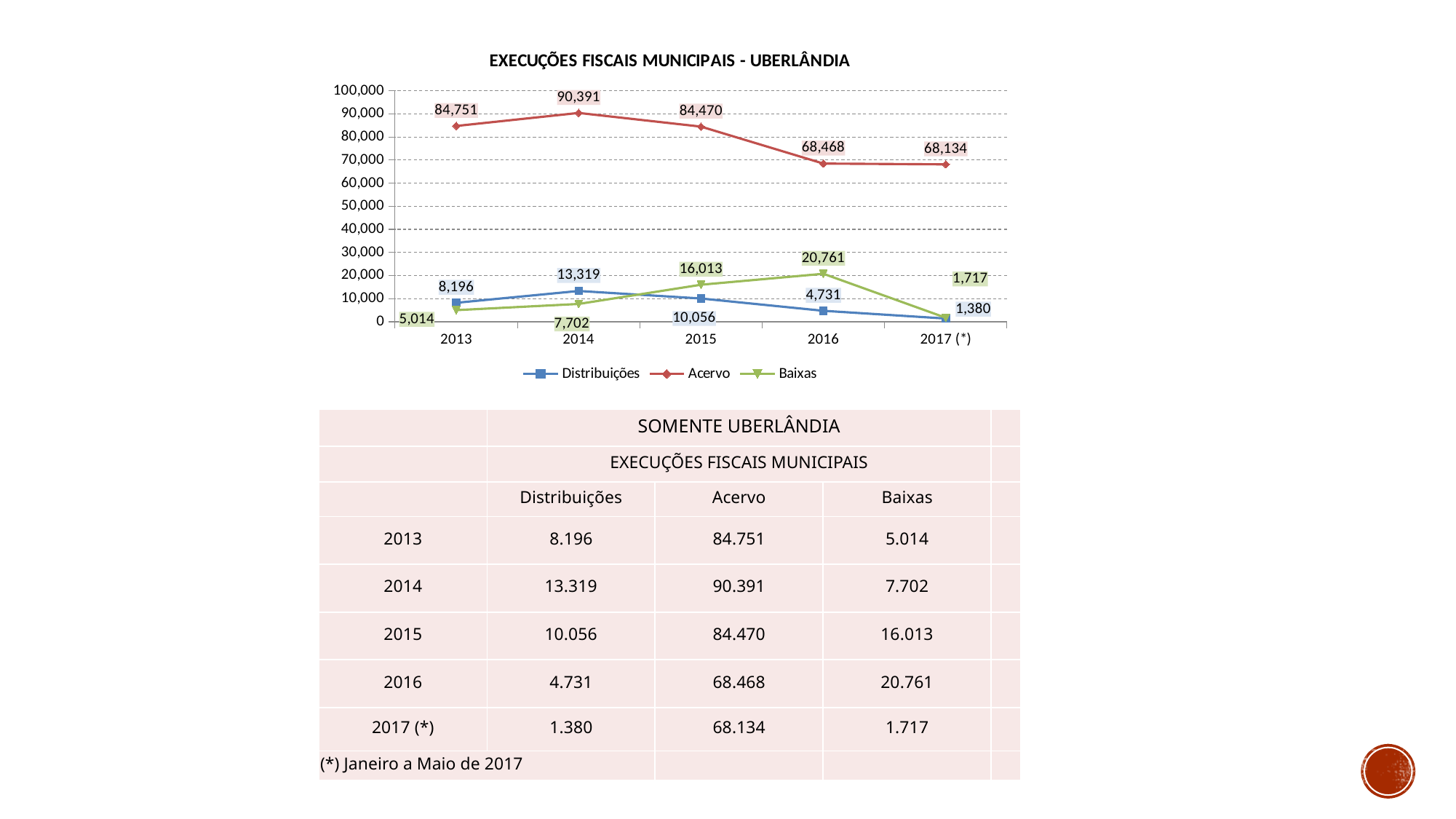
Which is larger in 2015, Distribuições or Baixas? Baixas How many series does the legend list? 3 What is the value of Baixas in 2016? 20,761 What kind of chart is shown? line chart What is the value of Acervo in 2014? 90,391 Is the value for Acervo in 2016 greater or less than 70,000? less Does Distribuições rise or fall from 2014 to 2017 (*)? fall In which year is Acervo highest? 2014 What is the value of Distribuições in 2017 (*)? 1,380 How many years are shown on the x axis? 5 What is the difference between Acervo in 2014 and Acervo in 2015? 5,921 In which year is Distribuições lowest? 2017 (*)